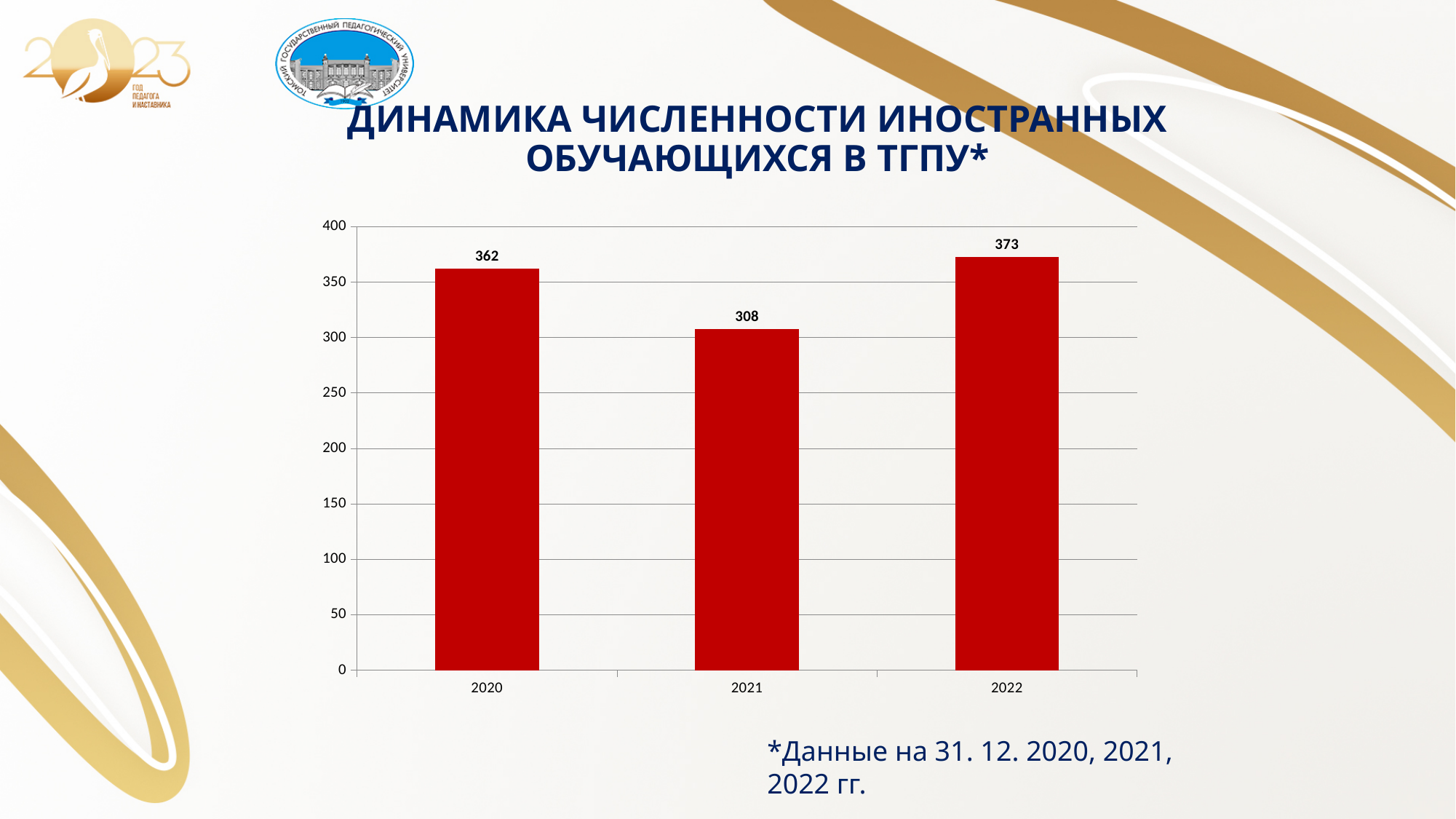
What is the value for 2021? 308 What is the value for 2020? 362 Which is larger, the value for 2020 or the value for 2021? 2020 What is the value for 2022? 373 What is the difference between the values for 2022 and 2021? 65 Is the value for 2021 greater or less than 350? less Which year has the highest value? 2022 What colour are the bars in the chart? red Which year has the lowest value? 2021 What is the difference between the values for 2020 and 2021? 54 How many years are shown on the x axis? 3 What kind of chart is shown on the slide? bar chart